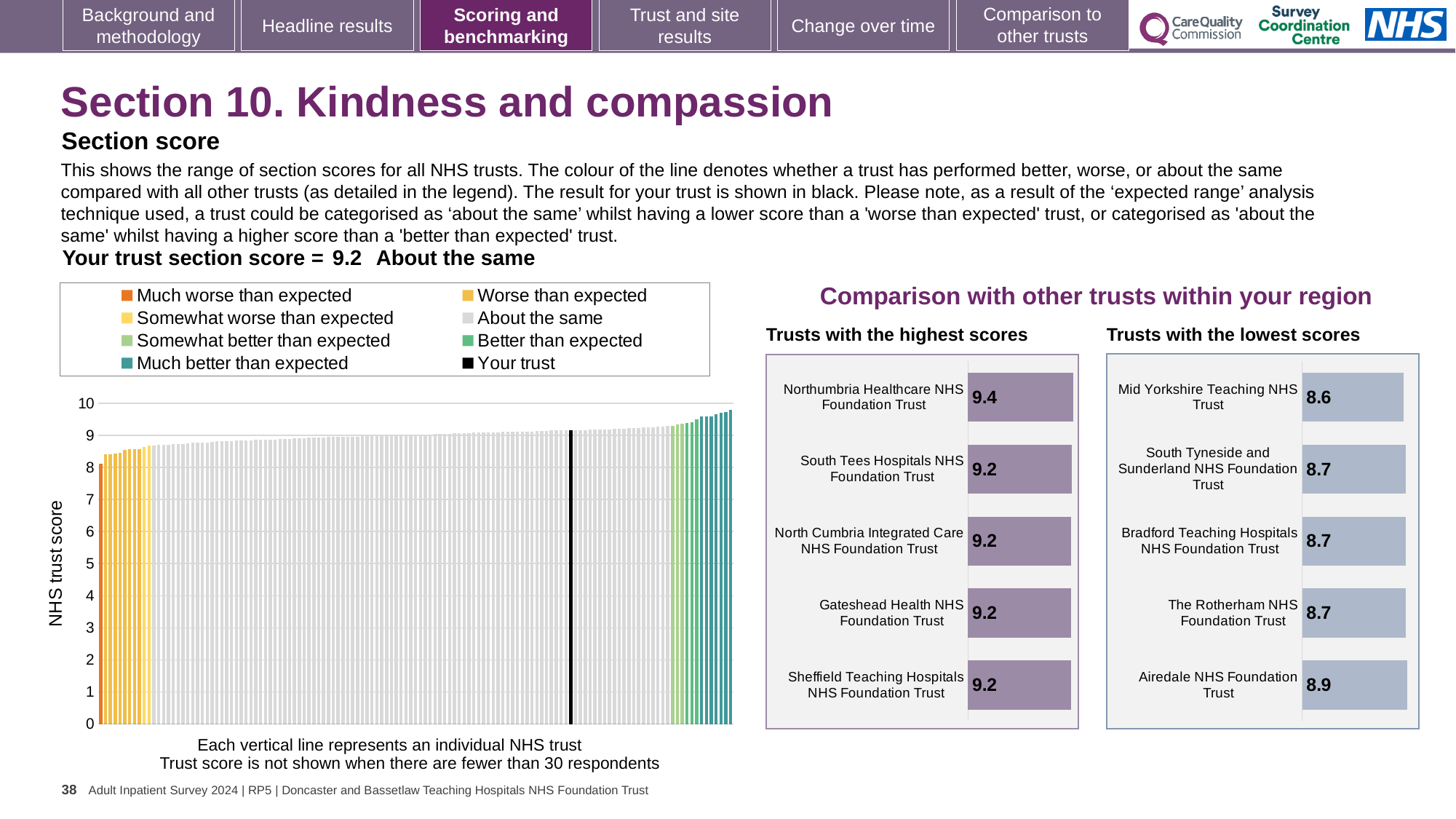
In the 'Trusts with the lowest scores' chart, what is the difference between the scores of Airedale NHS Foundation Trust and Mid Yorkshire Teaching NHS Trust? 0.3 How many trusts are shown in the 'Trusts with the lowest scores' chart? 5 In the 'Section score' chart on the left, is the value of the leftmost (orange) bar greater or less than 9? less Which has the higher score: Airedale NHS Foundation Trust in the 'Trusts with the lowest scores' chart or Northumbria Healthcare NHS Foundation Trust in the 'Trusts with the highest scores' chart? Northumbria Healthcare NHS Foundation Trust What kind of chart is the 'Section score' chart on the left of the slide? Bar chart In the 'Trusts with the highest scores' chart, what is the score for Northumbria Healthcare NHS Foundation Trust? 9.4 In the 'Trusts with the lowest scores' chart, what is the score for Airedale NHS Foundation Trust? 8.9 In the 'Trusts with the highest scores' chart, which trust has the highest score? Northumbria Healthcare NHS Foundation Trust In the 'Trusts with the highest scores' chart, what is the difference between the scores of Northumbria Healthcare NHS Foundation Trust and Sheffield Teaching Hospitals NHS Foundation Trust? 0.2 In the 'Trusts with the lowest scores' chart, which trust has the lowest score? Mid Yorkshire Teaching NHS Trust How many entries does the legend of the 'Section score' chart on the left list? 8 In the 'Section score' chart on the left, do the trust scores rise or fall from left to right along the x axis? Rise